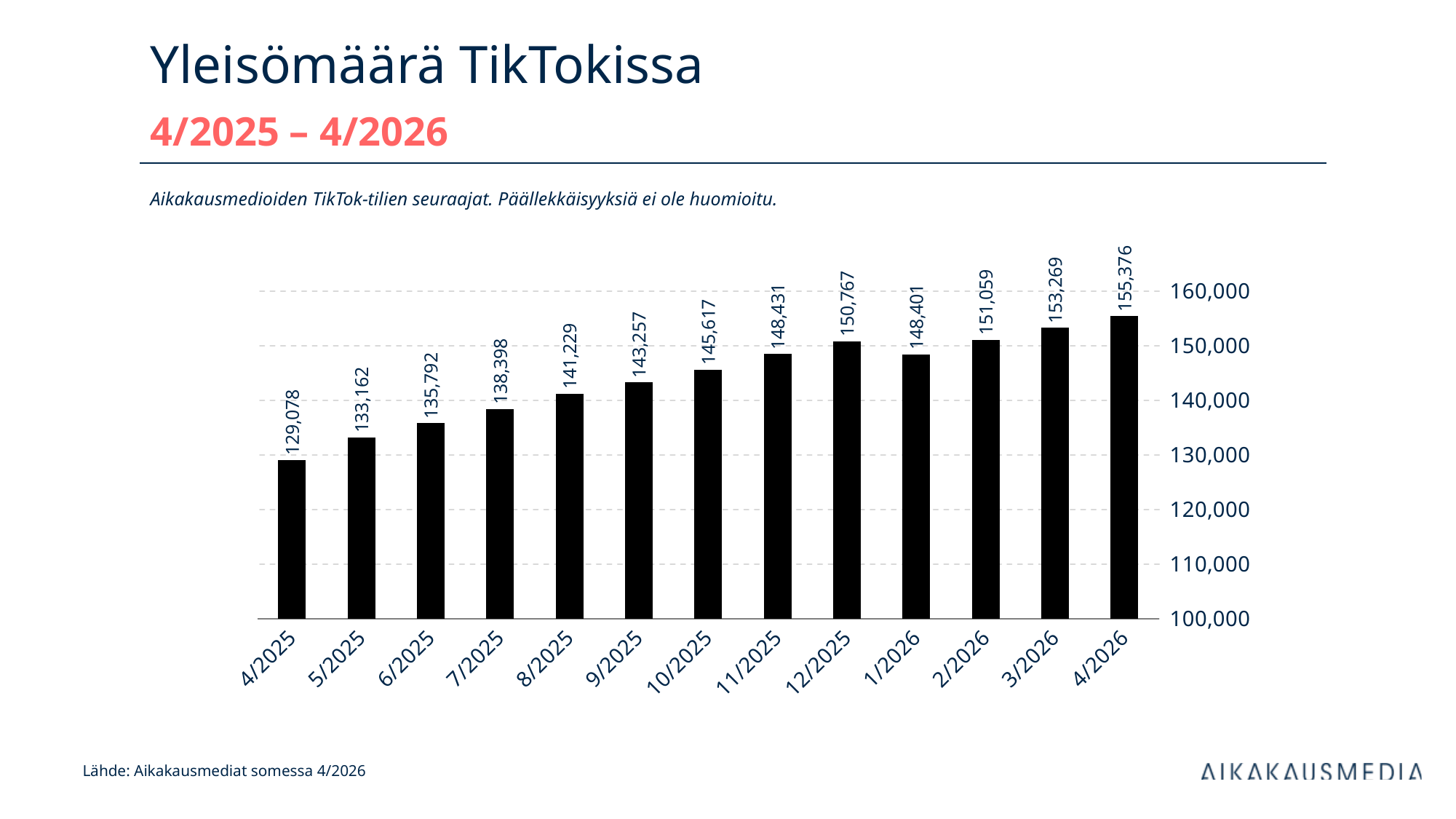
What is the difference between the values for 4/2026 and 4/2025? 26,298 What is the value for 4/2025? 129,078 What is the value for 12/2025? 150,767 Is the value for 8/2025 greater or less than 140,000? greater Which month has the highest value? 4/2026 Which is larger, the value for 12/2025 or the value for 1/2026? 12/2025 What is the title of the chart on the slide? Yleisömäärä TikTokissa How many months are shown on the x axis? 13 What is the difference between the values for 12/2025 and 1/2026? 2,366 What is the value for 1/2026? 148,401 What kind of chart is shown on the slide? bar chart Which month has the lowest value? 4/2025